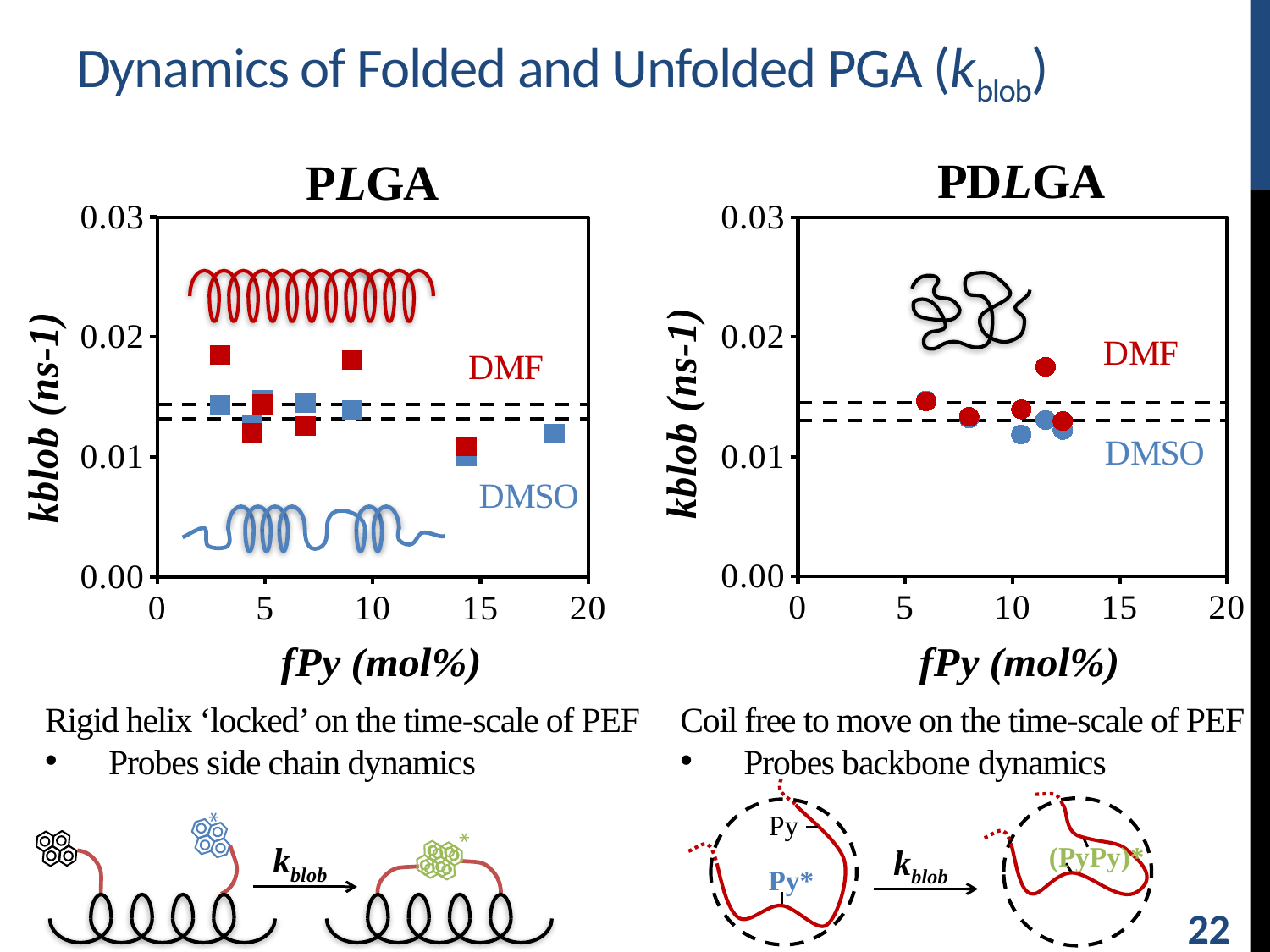
In the PDLGA chart, is the lowest DMSO point greater or less than 0.01? greater In the PLGA chart, is the DMF value at the lowest fPy (around 3 mol%) greater or less than 0.02? less In the PLGA chart, is the DMF value at the lowest fPy (around 3 mol%) greater or less than 0.01? greater In the PDLGA chart, which series contains the highest plotted kblob value? DMF In the PLGA chart, at the lowest fPy (around 3 mol%), which series has the larger kblob value, DMF or DMSO? DMF What kind of chart is the PLGA chart on the left? scatter chart What kind of chart is the PDLGA chart on the right? scatter chart In the PLGA chart, how many data series are labelled? 2 In the PDLGA chart, which two solvents are labelled as series? DMF and DMSO In the PLGA chart, which series contains the lowest plotted kblob value? DMSO What is the x-axis label of the PLGA chart? fPy (mol%)